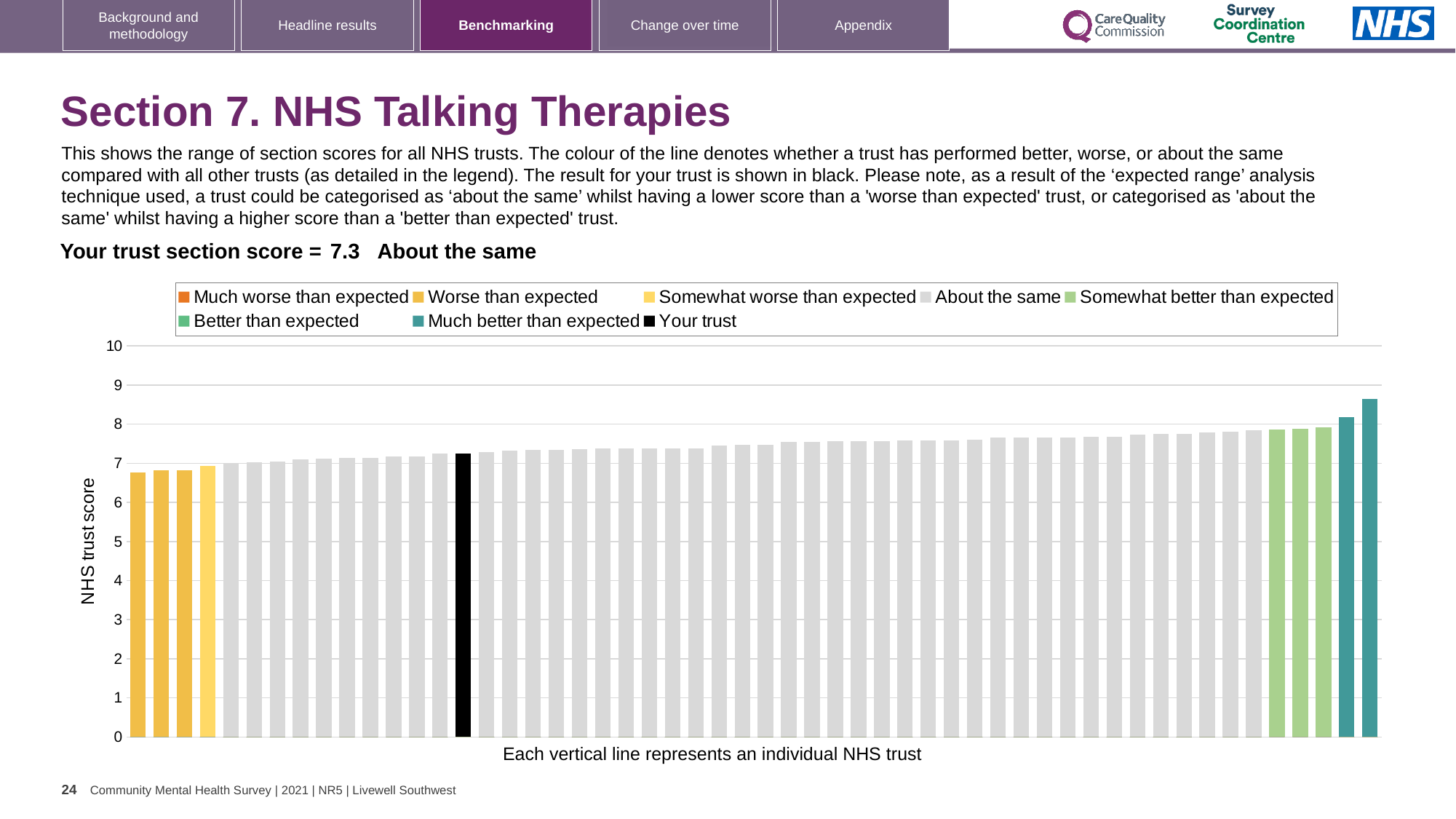
Do the bar values rise or fall from left to right along the x axis? rise What is the label on the vertical axis of the chart? NHS trust score Which legend category is your trust placed in? About the same Is the value of the shortest bar greater or less than 7? less What kind of chart is shown on the slide? bar chart How many bars are coloured as 'Much better than expected'? 2 How many bars are coloured as 'Somewhat better than expected'? 3 Is the value of the tallest bar greater or less than 8? greater How many entries does the chart legend list? 8 Which legend category does the tallest bar belong to? Much better than expected Is the value for your trust greater or less than 7? greater What is the section score for your trust shown on the slide? 7.3